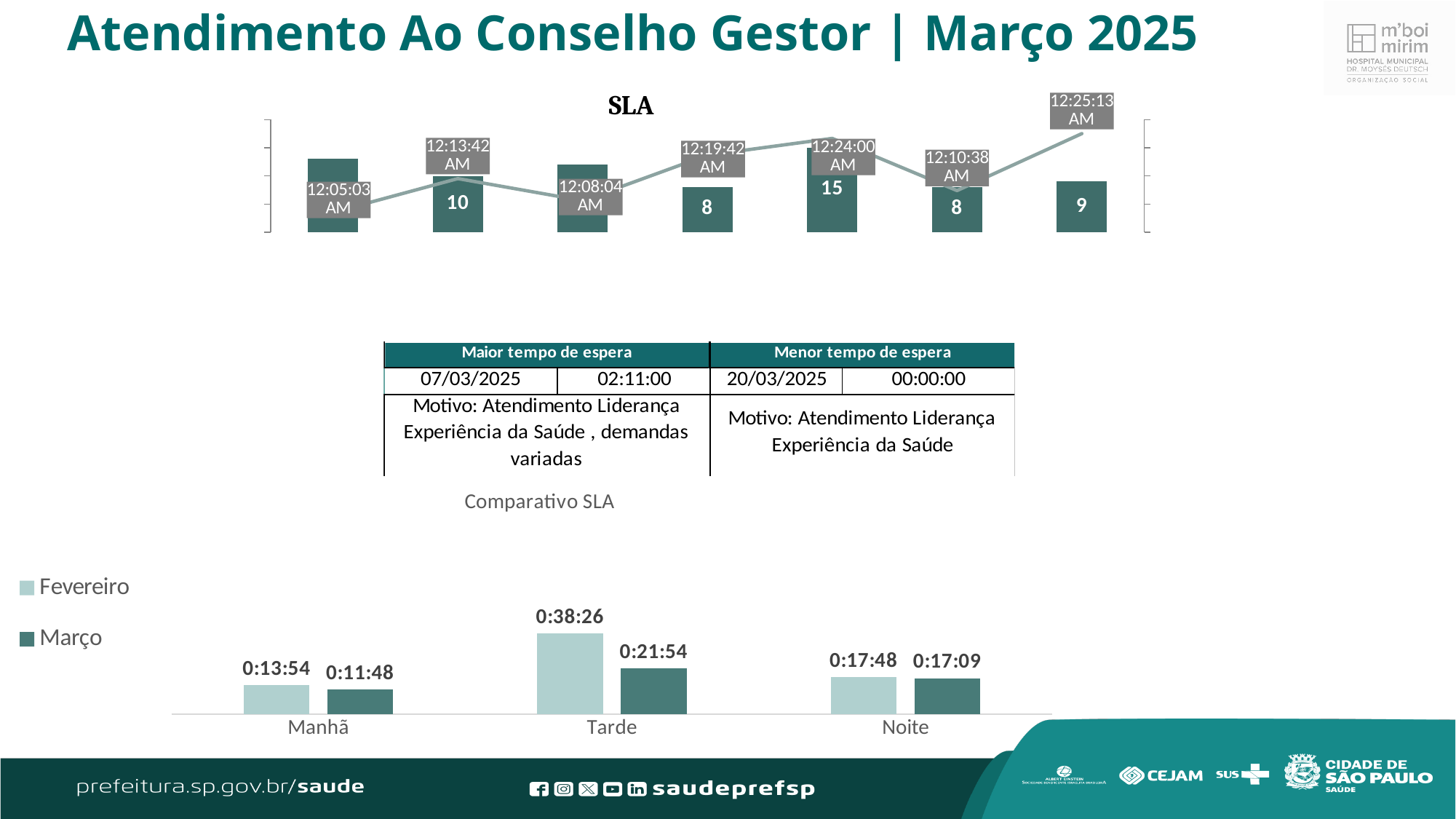
In the top chart (SLA), what is the lowest time value shown on the line? 12:05:03 AM In the bottom chart (Comparativo SLA), how many series does the legend list? 2 What kind of chart is the bottom chart (Comparativo SLA)? Bar chart In the bottom chart (Comparativo SLA), how many categories are shown on the x axis? 3 In the bottom chart (Comparativo SLA), what is the Fevereiro value for Tarde? 0:38:26 In the bottom chart (Comparativo SLA), which category has the lowest Março value? Manhã In the top chart (SLA), what is the highest time value shown on the line? 12:25:13 AM In the bottom chart (Comparativo SLA), what is the Março value for Noite? 0:17:09 In the top chart (SLA), how many data points does the line have? 7 In the bottom chart (Comparativo SLA), which is larger for Tarde: Fevereiro or Março? Fevereiro In the bottom chart (Comparativo SLA), what is the Março value for Manhã? 0:11:48 In the bottom chart (Comparativo SLA), which category has the highest Fevereiro value? Tarde